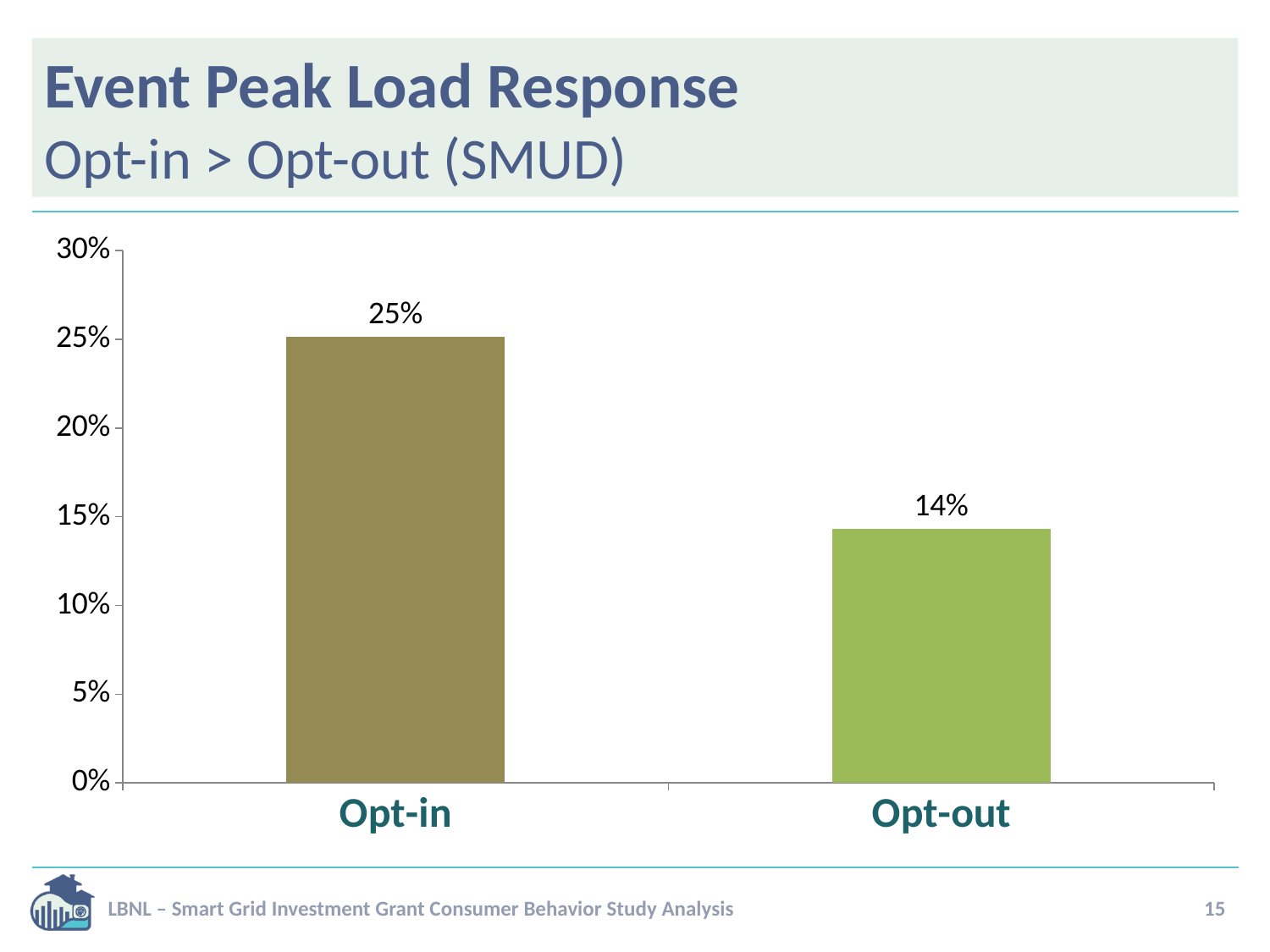
Which is larger, the value for Opt-in or the value for Opt-out? Opt-in What is the title of the slide containing the chart? Event Peak Load Response Which category has the highest value? Opt-in What is the difference between the Opt-in and Opt-out values? 11% How many categories are shown on the chart? 2 What is the maximum value shown on the vertical axis? 30% What is the event peak load response for Opt-in? 25% Is the value for Opt-out greater or less than 15%? less What kind of chart is shown on the slide? Bar chart Which category has the lowest value? Opt-out What is the event peak load response for Opt-out? 14% Is the value for Opt-in greater or less than 20%? greater